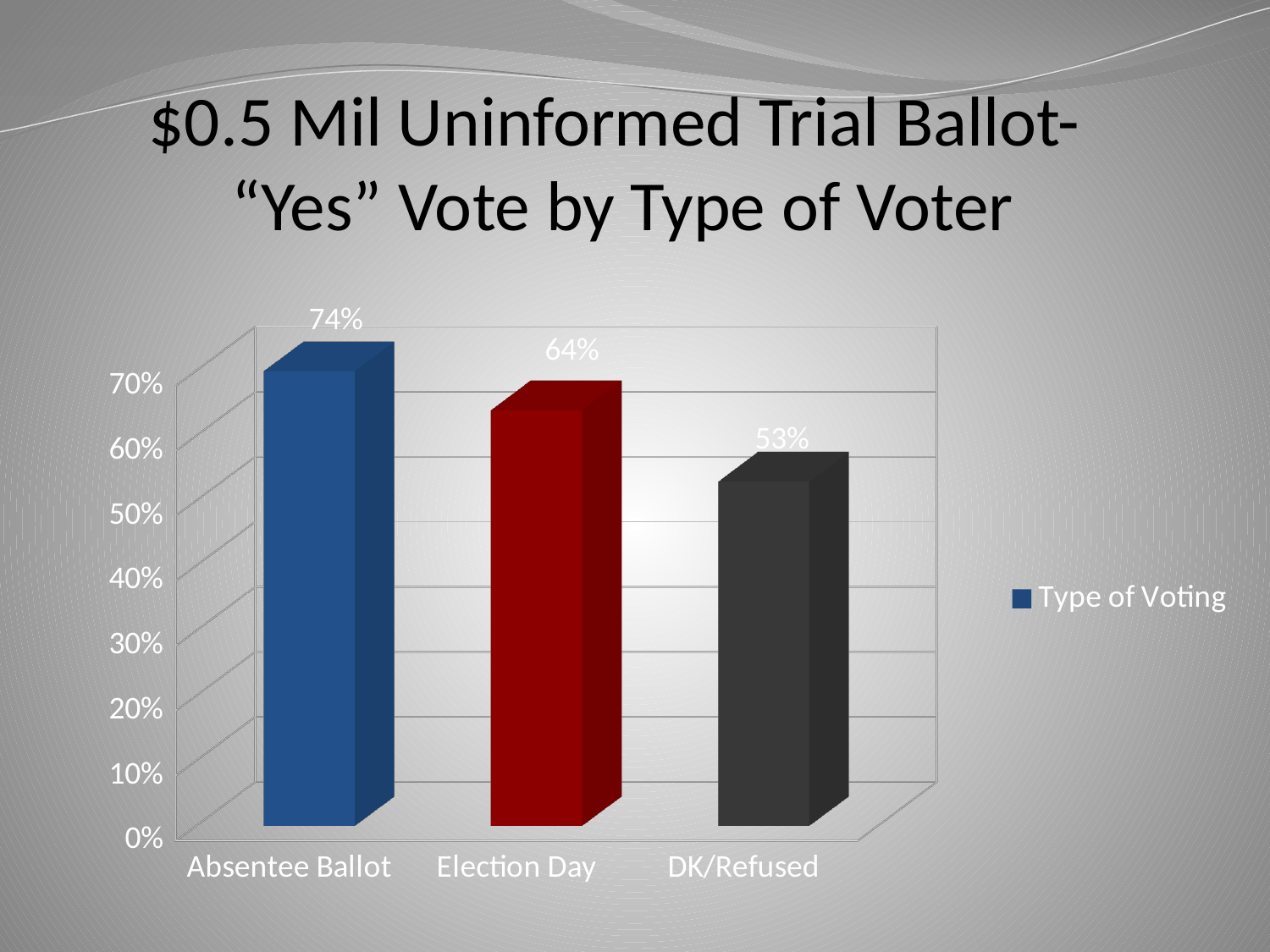
Is the value for DK/Refused greater or less than 60%? less How many voter categories are shown on the chart? 3 What is the "Yes" vote percentage for Absentee Ballot voters? 74% Which category has the lowest "Yes" vote percentage? DK/Refused What kind of chart is shown on the slide? Bar chart What is the legend entry shown on the chart? Type of Voting What is the "Yes" vote percentage for the DK/Refused category? 53% Which type of voter has the highest "Yes" vote percentage? Absentee Ballot What is the difference in "Yes" vote percentage between Election Day and DK/Refused? 11% What is the difference in "Yes" vote percentage between Absentee Ballot and Election Day voters? 10% What is the "Yes" vote percentage for Election Day voters? 64% Which is larger, the "Yes" vote for Election Day or for DK/Refused? Election Day